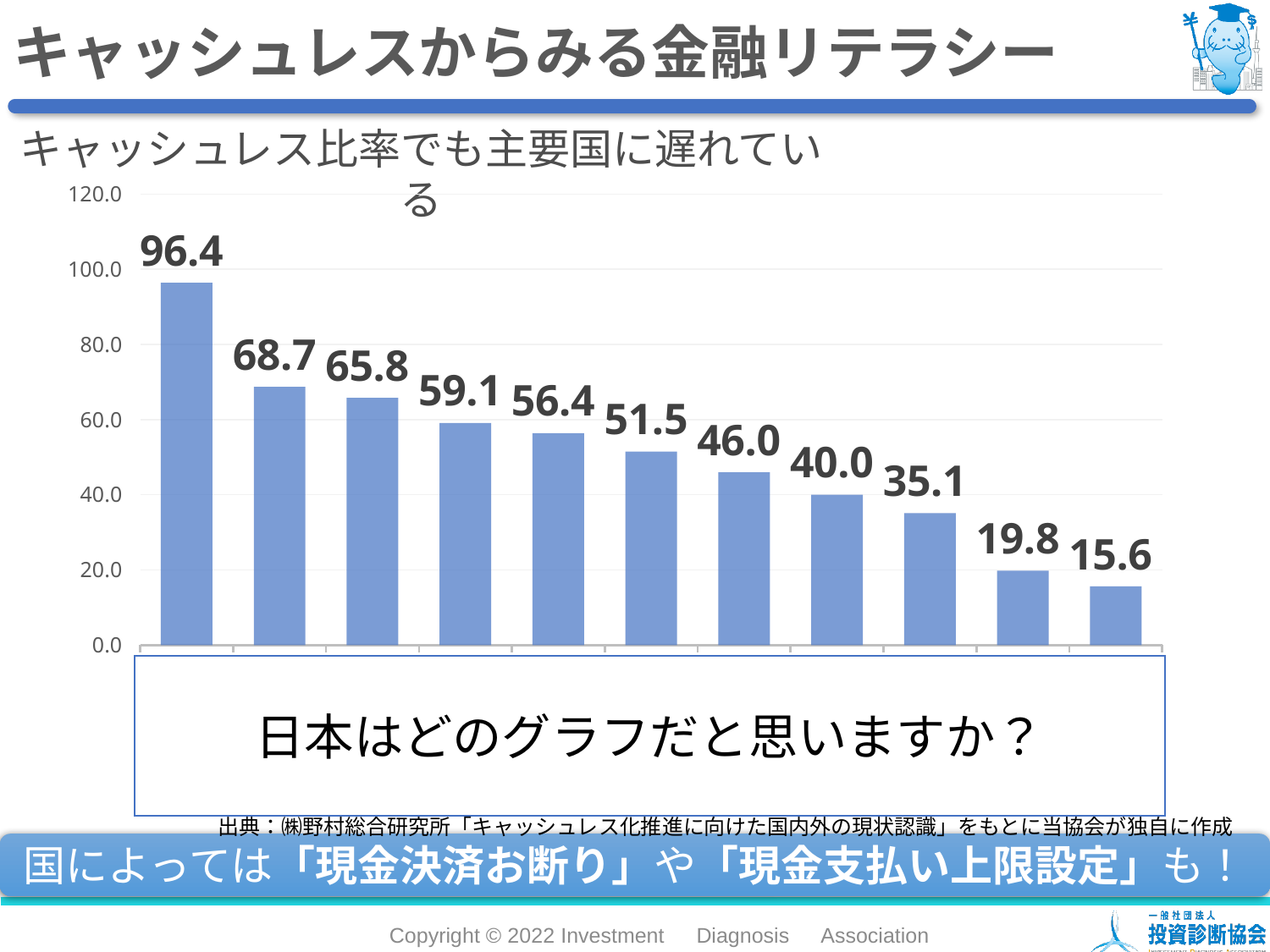
What is the difference between the bar labelled 40.0 and the bar labelled 35.1? 4.9 What is the value of the tallest bar in the chart? 96.4 Do the bar values rise or fall from left to right across the chart? fall What is the value of the shortest bar in the chart? 15.6 What is the title of the chart? キャッシュレス比率でも主要国に遅れている How many bars are plotted in the chart? 11 What kind of chart is shown on the slide? bar chart Which is larger, the third bar from the left or the fourth bar from the left? the third bar (65.8) What is the value shown on the second bar from the right? 19.8 What is the value shown on the second bar from the left? 68.7 What is the value shown on the fifth bar from the left? 56.4 What is the difference between the first bar (96.4) and the second bar (68.7)? 27.7